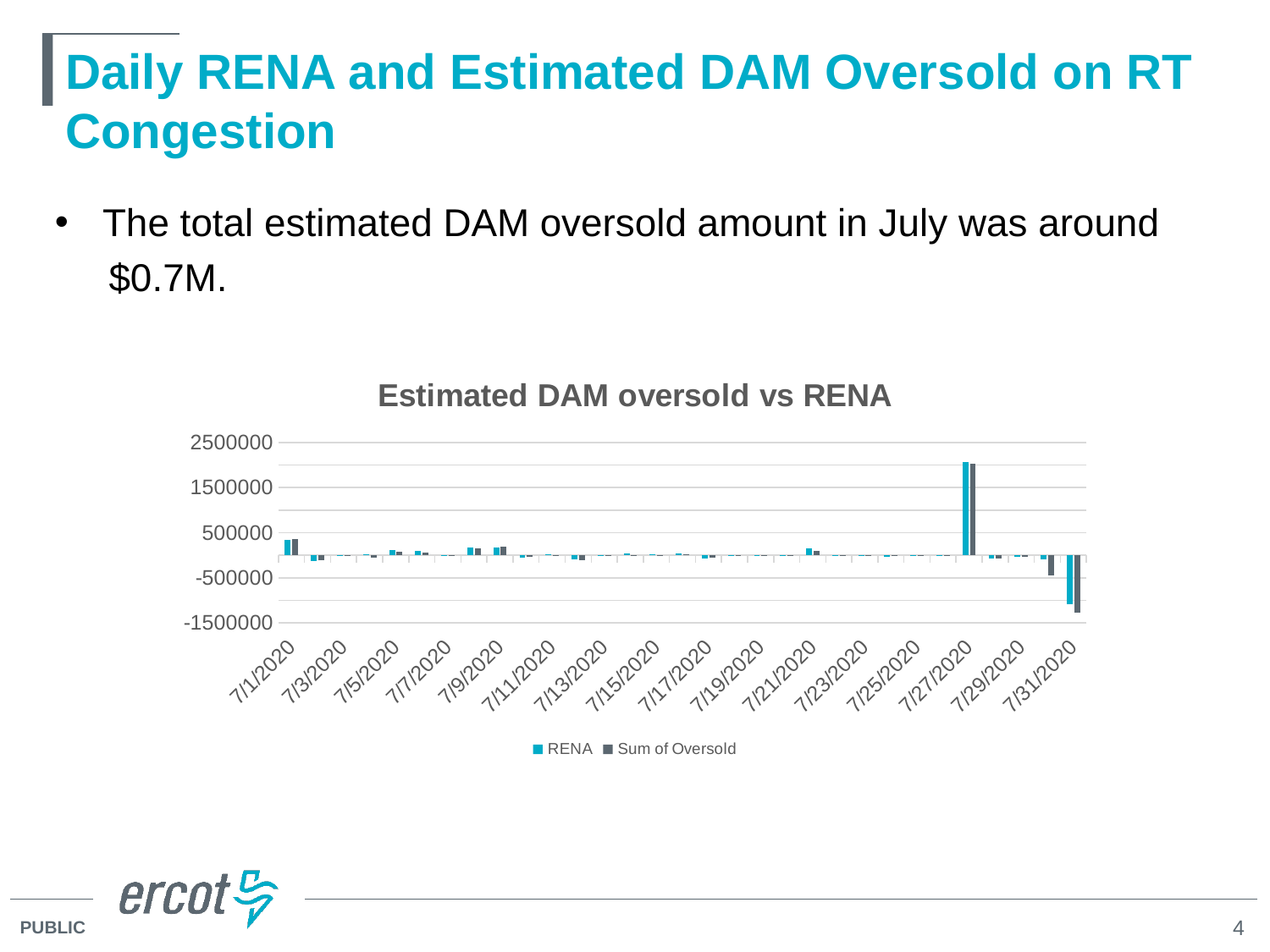
How many series does the legend of the chart list? 2 On which date does the Sum of Oversold series reach its lowest value? 7/31/2020 Which date has the larger RENA value, 7/1/2020 or 7/27/2020? 7/27/2020 What are the two series named in the chart legend? RENA and Sum of Oversold Is the Sum of Oversold value on 7/31/2020 greater or less than -500000? less What is the title of the chart? Estimated DAM oversold vs RENA Is the RENA value on 7/27/2020 greater or less than 1500000? greater What kind of chart is shown on the slide? Bar chart On which date does the RENA series reach its highest value? 7/27/2020 Which date has the larger RENA value, 7/1/2020 or 7/9/2020? 7/1/2020 How many date labels are shown on the x axis of the chart? 16 Is the RENA value on 7/1/2020 greater or less than 500000? less